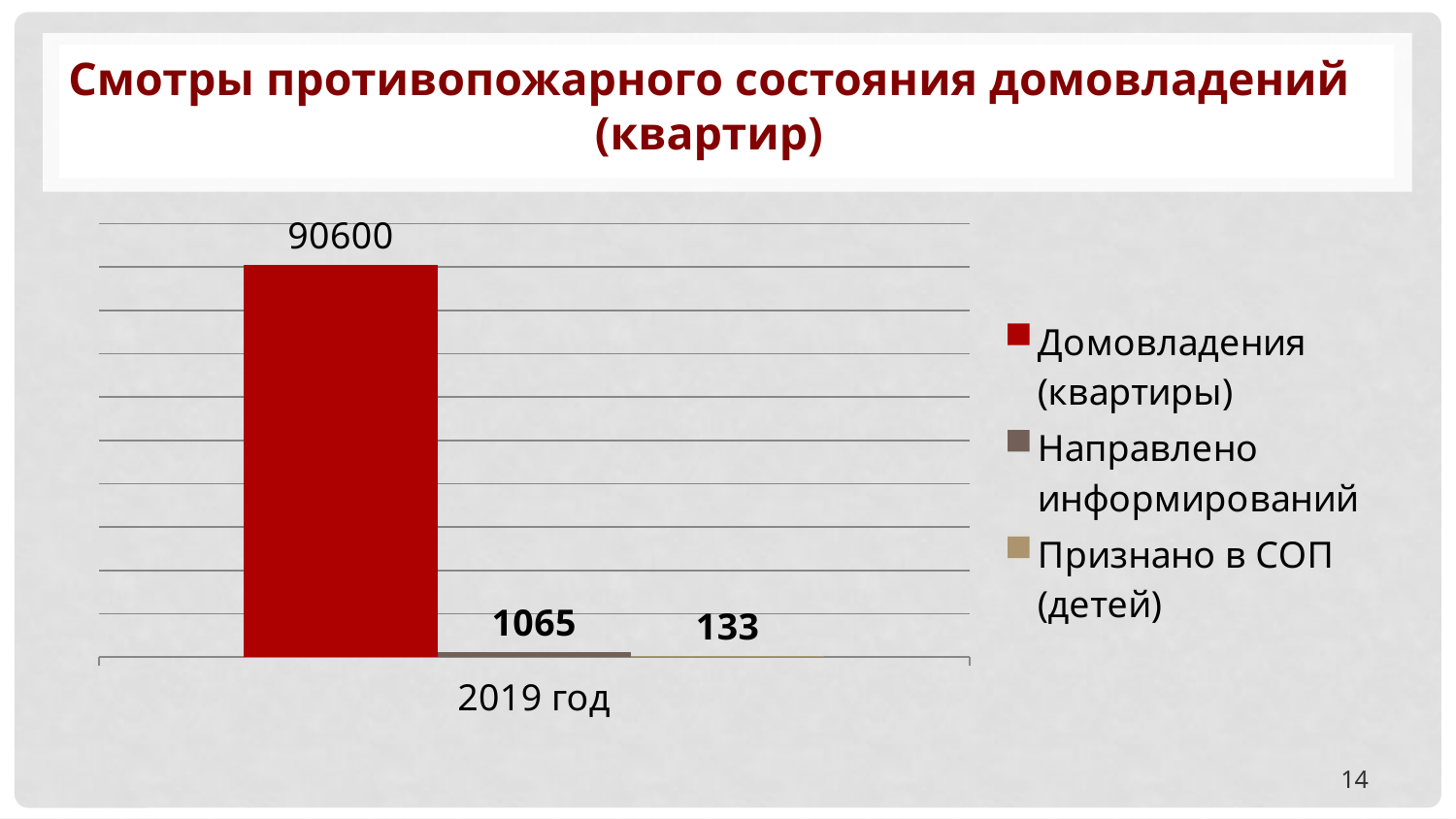
What is the value for Признано в СОП (детей) in 2019 год? 133 What is the value for Домовладения (квартиры) in 2019 год? 90600 How many series does the legend list? 3 Which series has the lowest value? Признано в СОП (детей) How many categories are shown on the x axis? 1 What is the category label on the x axis? 2019 год What is the difference between Направлено информирований and Признано в СОП (детей)? 932 What kind of chart is shown on the slide? Bar chart What is the value for Направлено информирований in 2019 год? 1065 Which is larger, Направлено информирований or Признано в СОП (детей)? Направлено информирований What is the difference between Домовладения (квартиры) and Направлено информирований? 89535 Which series has the highest value? Домовладения (квартиры)